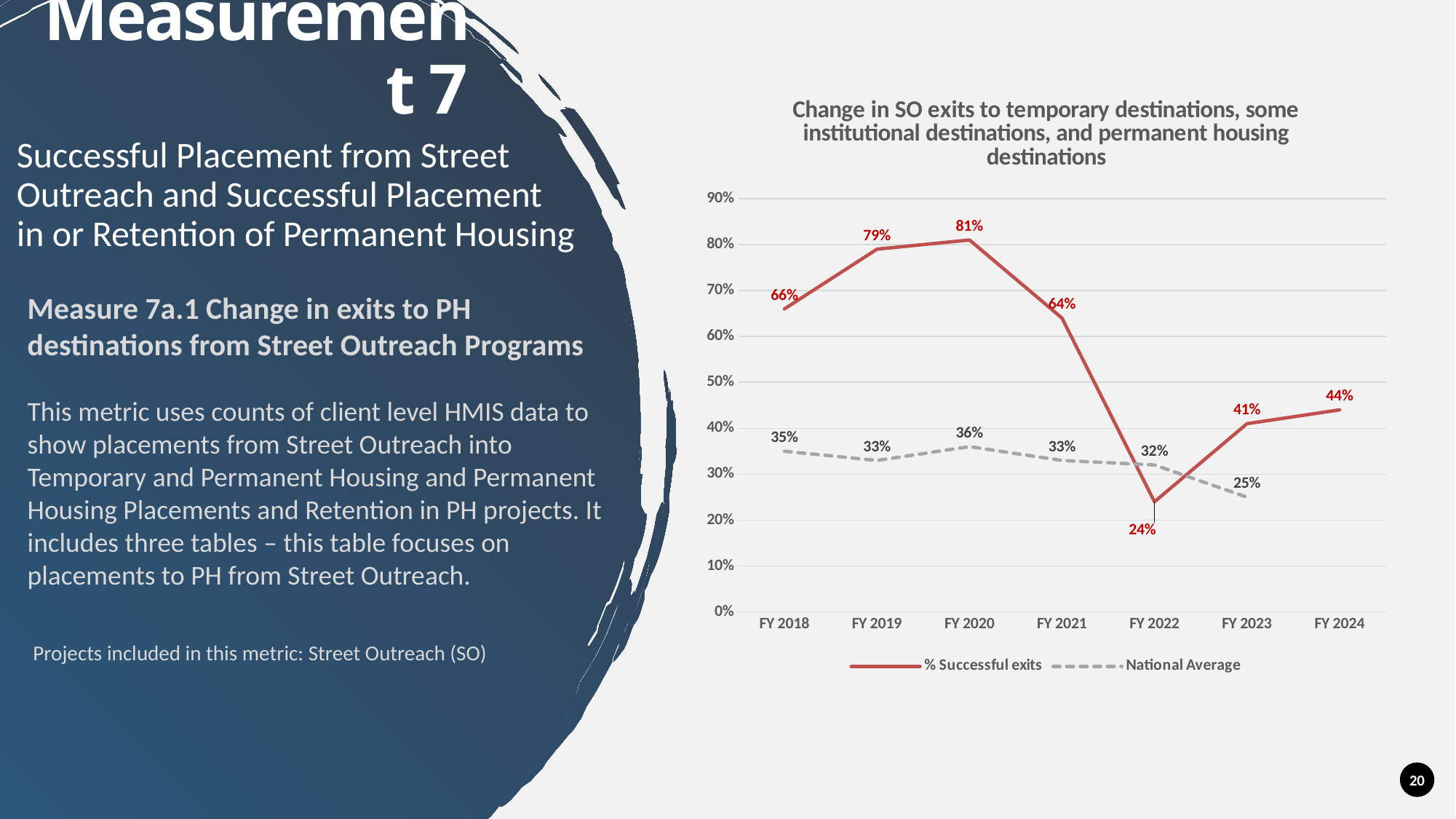
What is the difference between the % Successful exits value and the National Average value in FY 2019? 46% In which fiscal year is the % Successful exits value highest? FY 2020 What is the % Successful exits value for FY 2022? 24% What is the % Successful exits value for FY 2020? 81% Which series is drawn as a dashed grey line? National Average How many series does the legend list? 2 Does the % Successful exits value rise or fall from FY 2022 to FY 2024? Rise How many fiscal years are shown on the x axis? 7 What kind of chart is shown on the slide? Line chart In which fiscal year is the % Successful exits value lowest? FY 2022 Which is larger in FY 2022: the % Successful exits value or the National Average value? National Average What is the National Average value for FY 2023? 25%